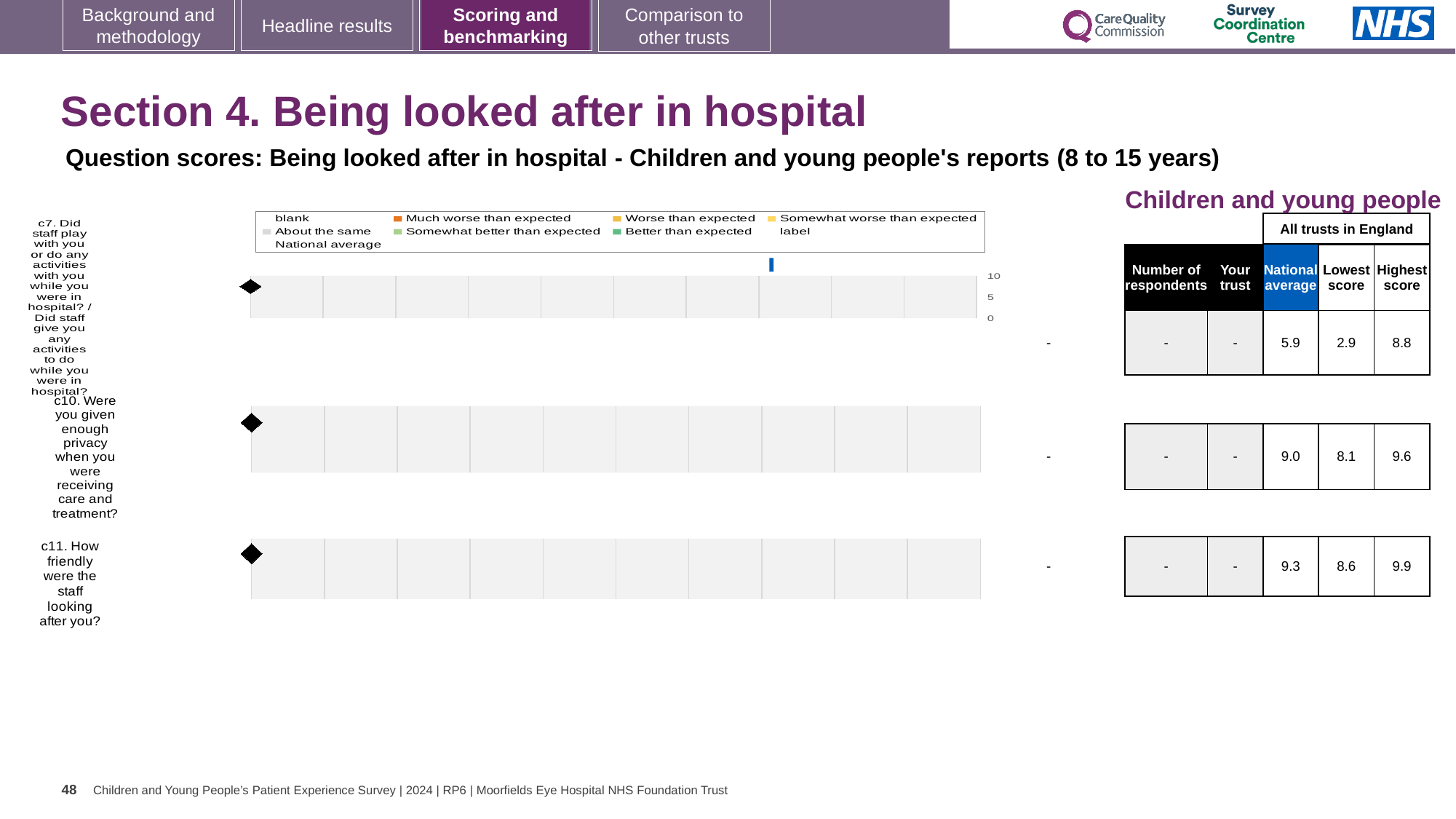
Which question has the higher National average, c7 or c11? c11 Which question has the highest National average in the table? c11 What is the subtitle describing the question scores shown on the slide? Question scores: Being looked after in hospital - Children and young people's reports (8 to 15 years) In the table, what is the National average score for c10 (enough privacy when receiving care and treatment)? 9.0 Which question has the lowest National average in the table? c7 In the table, what is the Lowest score for c7 (did staff play with you or do any activities with you)? 2.9 What is the difference between the Highest score and the Lowest score for c10? 1.5 What kind of chart is shown on the slide? bar chart What is the highest tick value shown on the chart's score axis? 10 How many survey questions (categories) are listed on the chart? 3 In the table, what is the Highest score for c11 (how friendly were the staff looking after you)? 9.9 In the table, what is shown as the Your trust score for c7? -